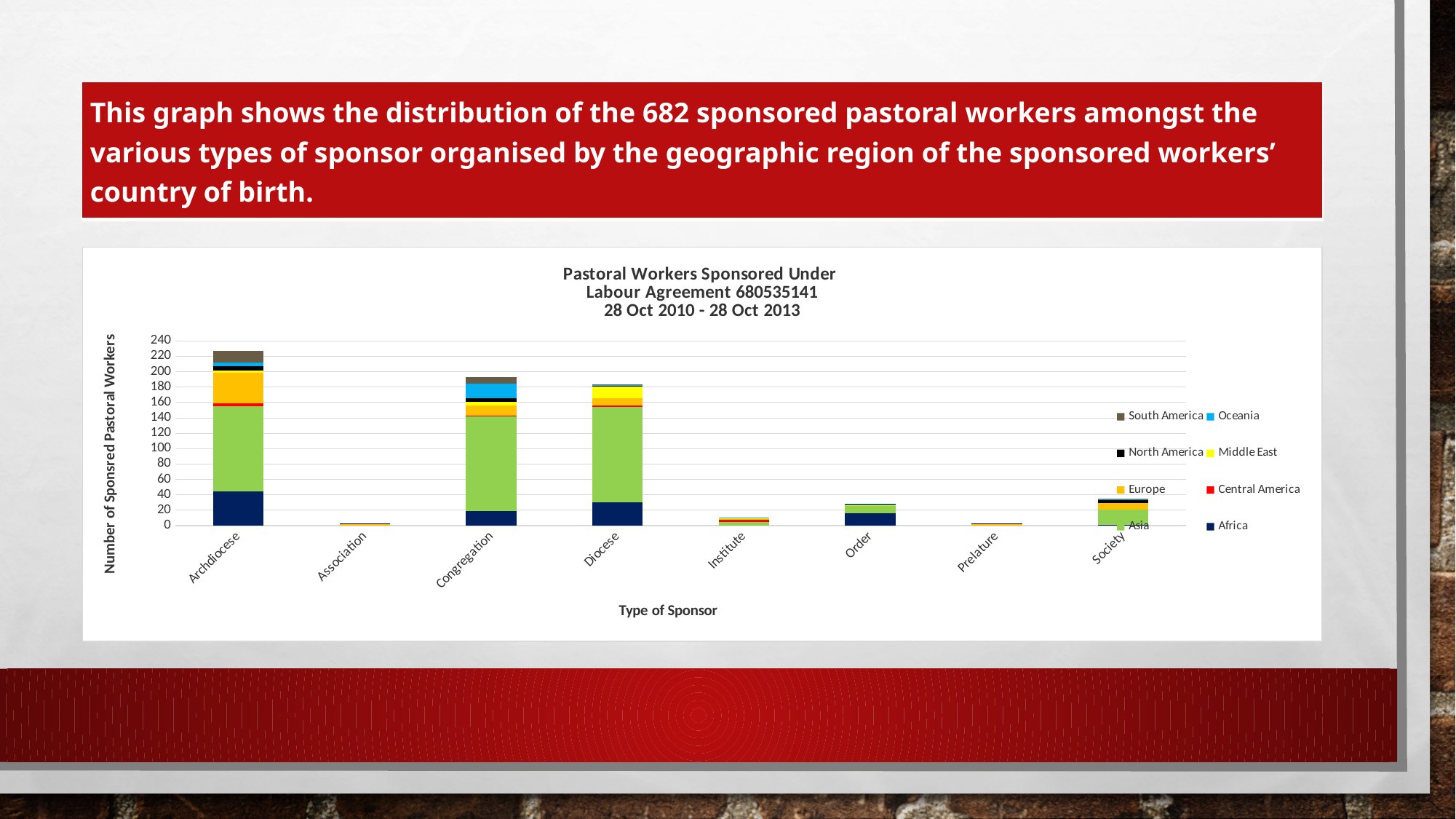
How many series does the legend list? 8 Is the total bar for Archdiocese greater or less than 200? greater What kind of chart is shown on the slide? Stacked bar chart Which has the taller stacked bar, Order or Institute? Order Is the total bar for Society greater or less than 60? less How many types of sponsor are shown on the x axis? 8 Which type of sponsor has the tallest stacked bar? Archdiocese Which has the taller stacked bar, Archdiocese or Congregation? Archdiocese Is the total bar for Diocese greater or less than 160? greater What is the label on the y axis of the chart? Number of Sponsred Pastoral Workers